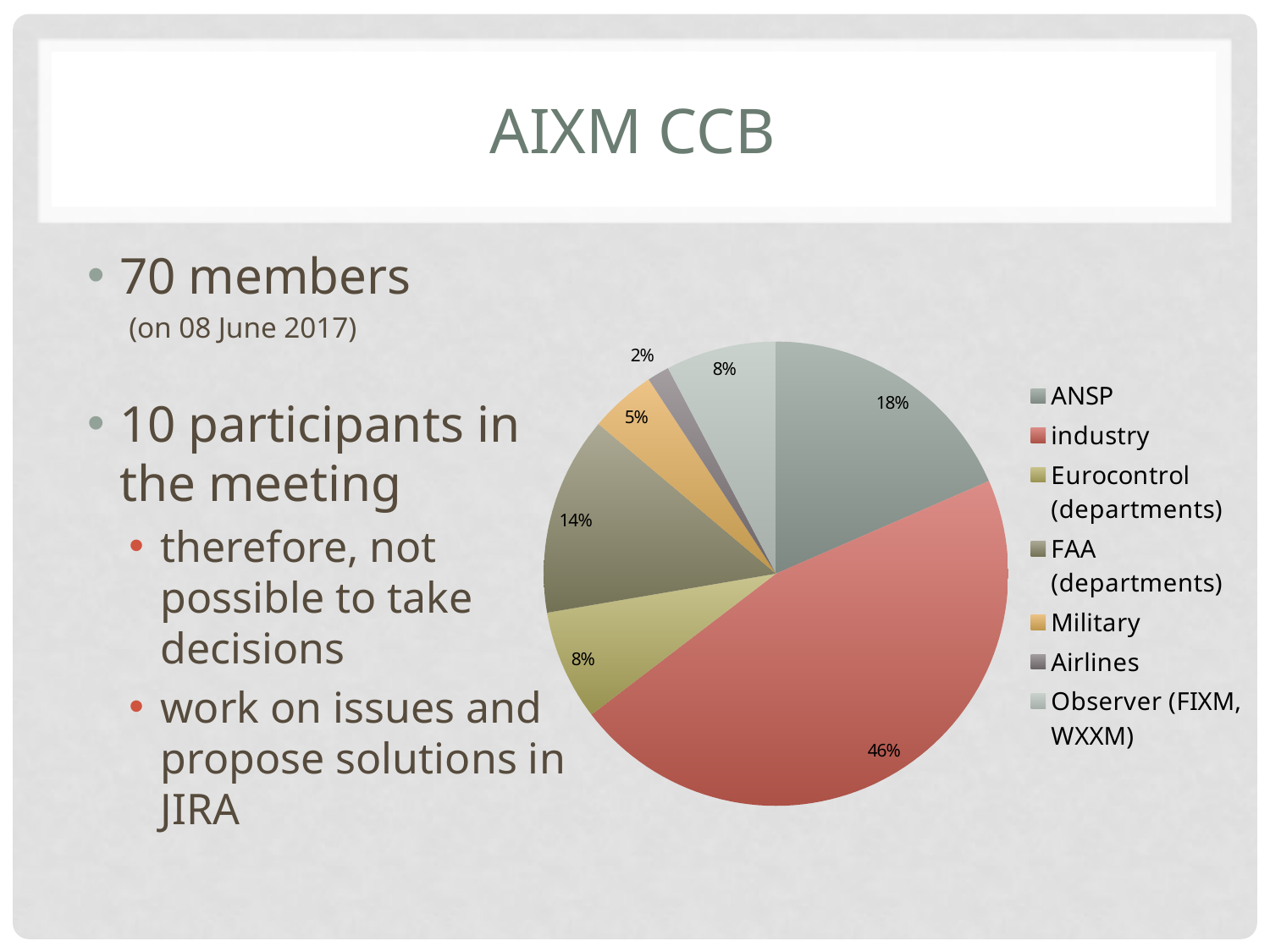
What share of the pie does industry hold? 46% What share of the pie does Military hold? 5% What share of the pie does ANSP hold? 18% How many categories does the legend of the pie chart list? 7 What is the difference in percentage points between the industry slice and the ANSP slice? 28 Which category has the smallest slice of the pie? Airlines Which legend entry is shown in red? industry What kind of chart is shown on the slide? pie chart Which category has the largest slice of the pie? industry Which slice is larger, FAA (departments) or Eurocontrol (departments)? FAA (departments)